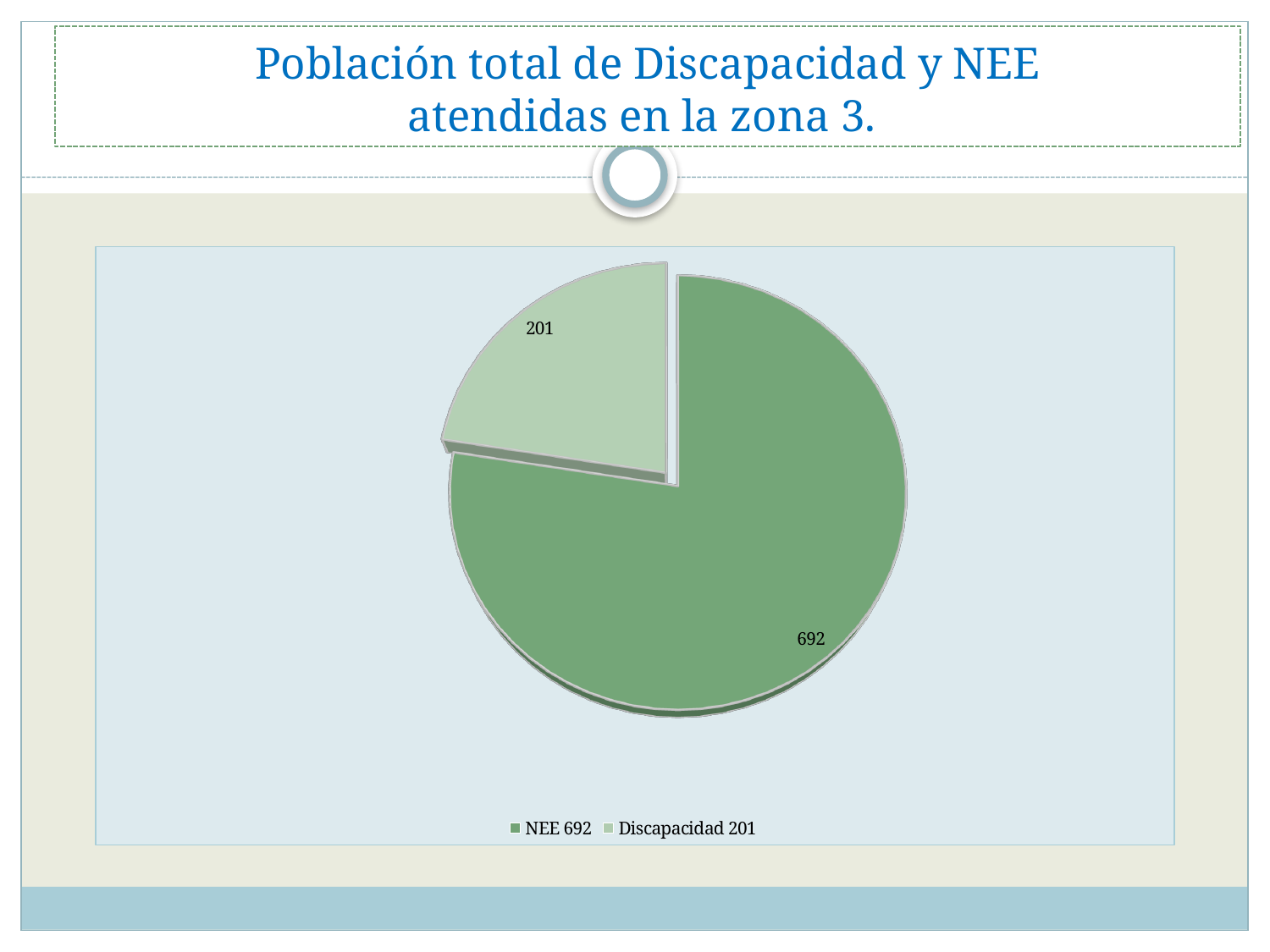
How many slices does the pie chart have? 2 Which category has the smallest slice in the pie chart? Discapacidad What is the value for NEE in the pie chart? 692 Which is larger, the value for NEE or the value for Discapacidad? NEE What is the title of the slide containing the pie chart? Población total de Discapacidad y NEE atendidas en la zona 3. What is the value for Discapacidad in the pie chart? 201 What kind of chart is shown on the slide? Pie chart What is the difference between the NEE value and the Discapacidad value? 491 What is the total of the two values shown in the pie chart? 893 Which category has the largest slice in the pie chart? NEE